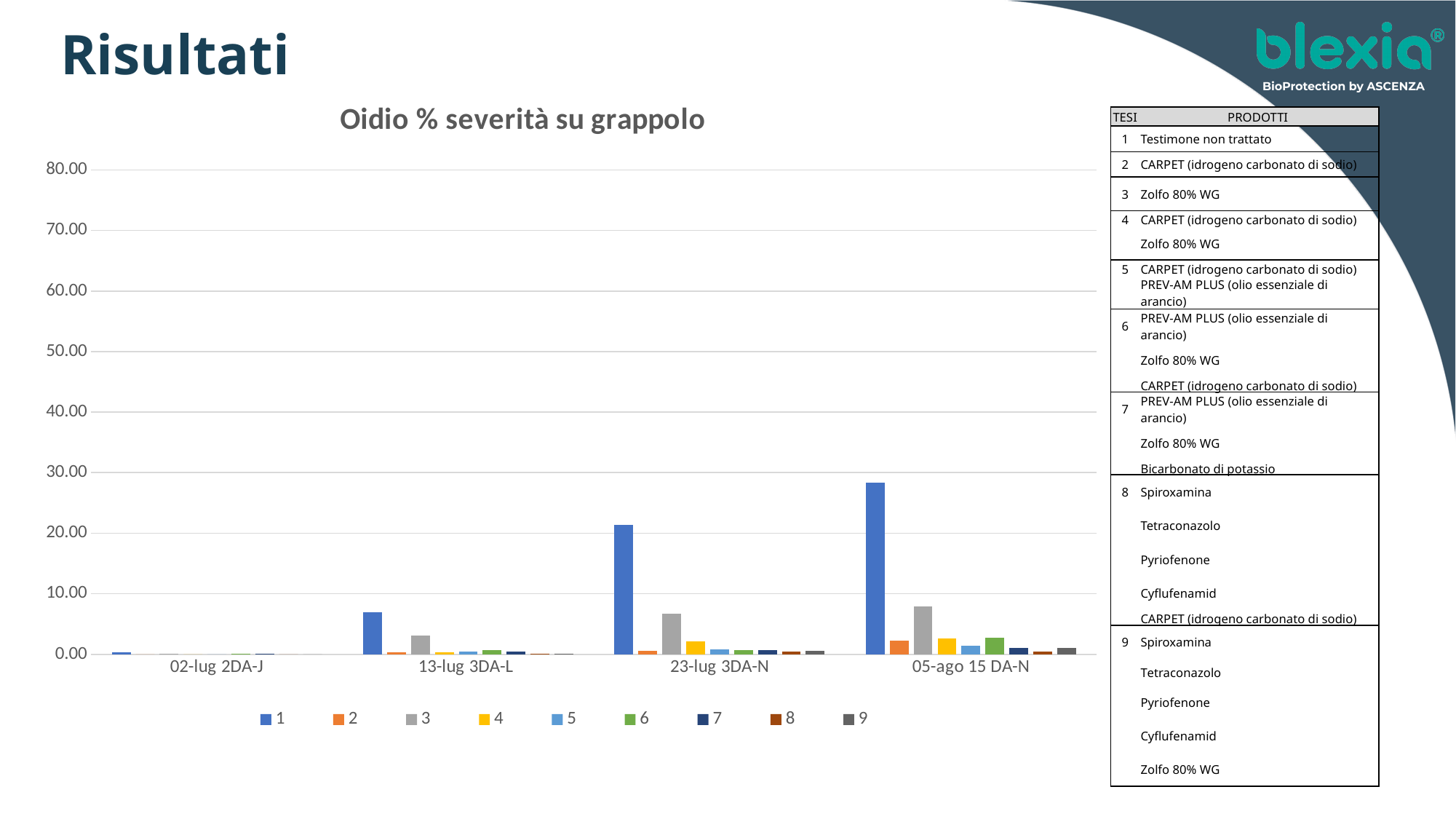
Is the value for series 1 at 05-ago 15 DA-N greater or less than 20.00? greater Which series has the highest value in the 23-lug 3DA-N category? 1 Is the value for series 1 at 23-lug 3DA-N greater or less than 10.00? greater How many series does the chart legend list? 9 What is the title of the chart? Oidio % severità su grappolo What is the label of the first category on the x axis? 02-lug 2DA-J What kind of chart is shown on the slide? bar chart At 05-ago 15 DA-N, which is larger: the value for series 1 or the value for series 3? series 1 Is the value for series 1 at 13-lug 3DA-L greater or less than 10.00? less Do the values for series 1 rise or fall from 02-lug 2DA-J to 05-ago 15 DA-N? rise How many categories are shown on the x axis of the chart? 4 Which series has the highest value in the 05-ago 15 DA-N category? 1